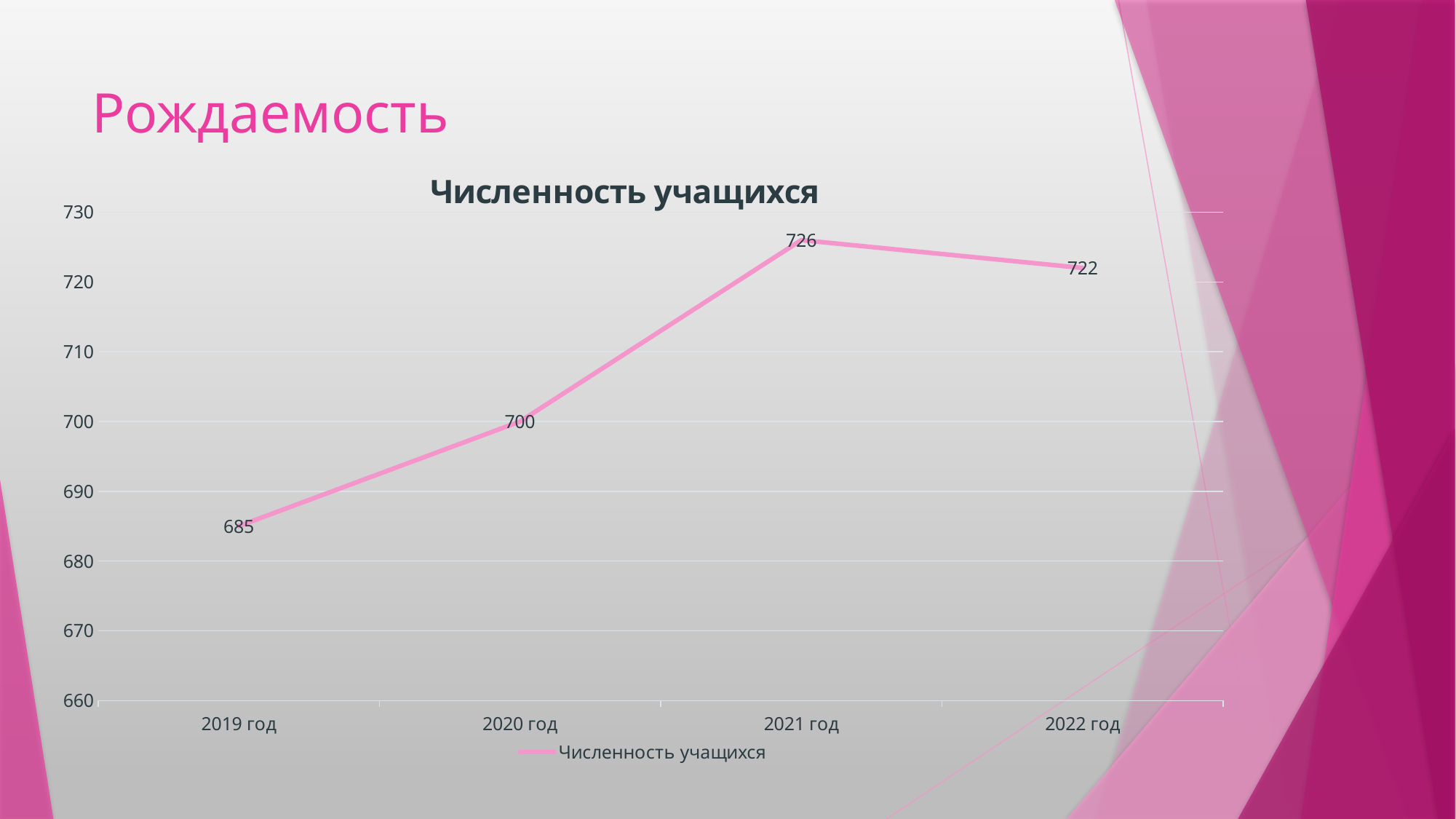
What is the value for 2022 год? 722 Which is larger, the value for 2020 год or the value for 2022 год? 2022 год What is the value for 2019 год? 685 How many years are plotted on the x axis? 4 Is the value for 2020 год greater or less than 690? greater What is the title of the chart? Численность учащихся What is the difference between the values for 2020 год and 2019 год? 15 What is the difference between the values for 2021 год and 2019 год? 41 What is the value for 2021 год? 726 Which year has the highest value? 2021 год What kind of chart is shown? line chart Which year has the lowest value? 2019 год